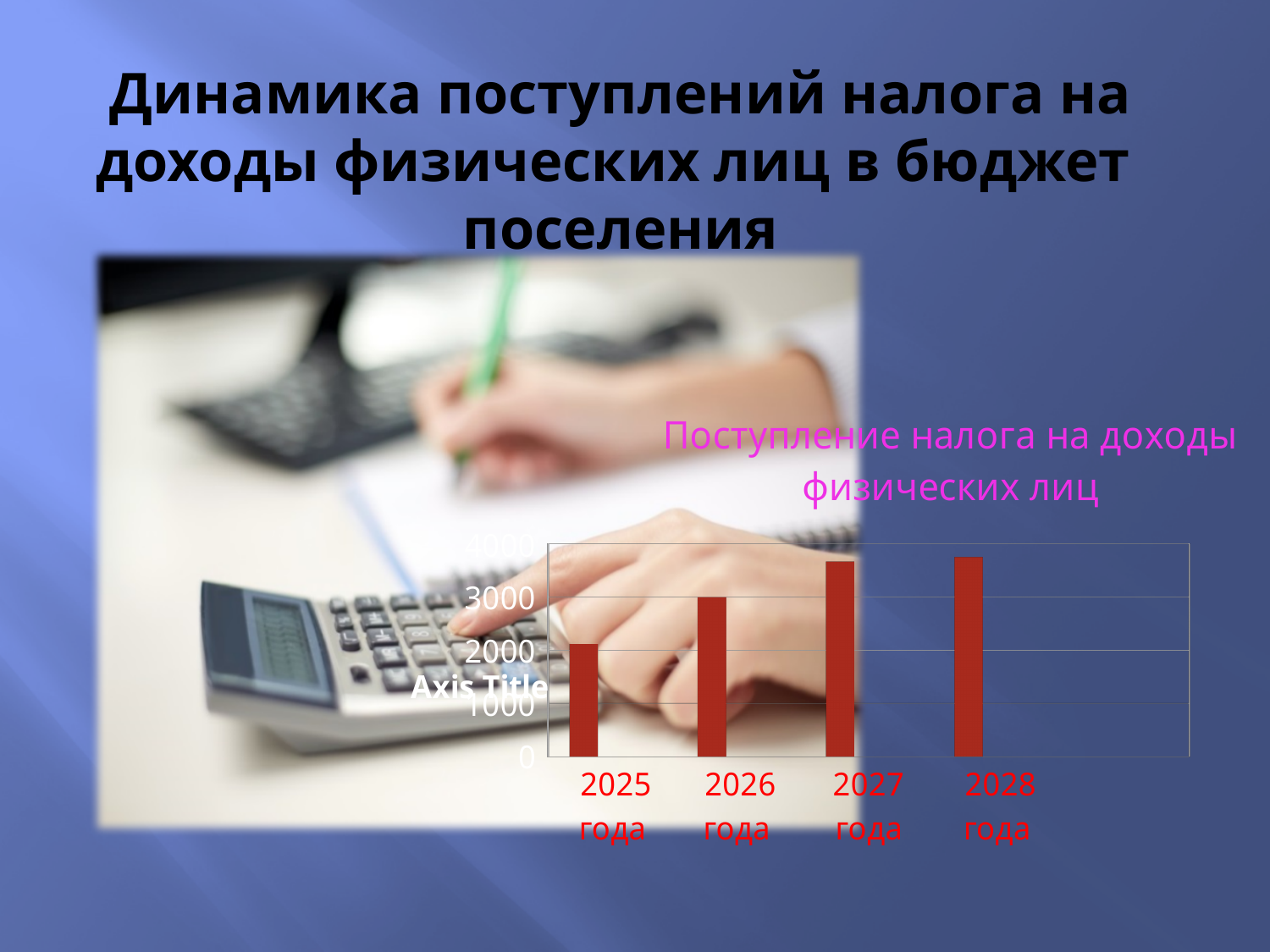
Is the value for 2026 года greater or less than 2000? greater Is the value for 2027 года greater or less than 3000? greater What is the title of the chart? Поступление налога на доходы физических лиц Which is larger, the value for 2026 года or the value for 2028 года? 2028 года Do the values in the chart rise or fall from 2025 to 2028? rise What kind of chart is shown on the slide? bar chart Which is larger, the value for 2025 года or the value for 2026 года? 2026 года Which year has the lowest value in the chart? 2025 года Is the value for 2025 года greater or less than 3000? less How many categories (years) are shown on the x axis of the chart? 4 What colour are the bars in the chart? red